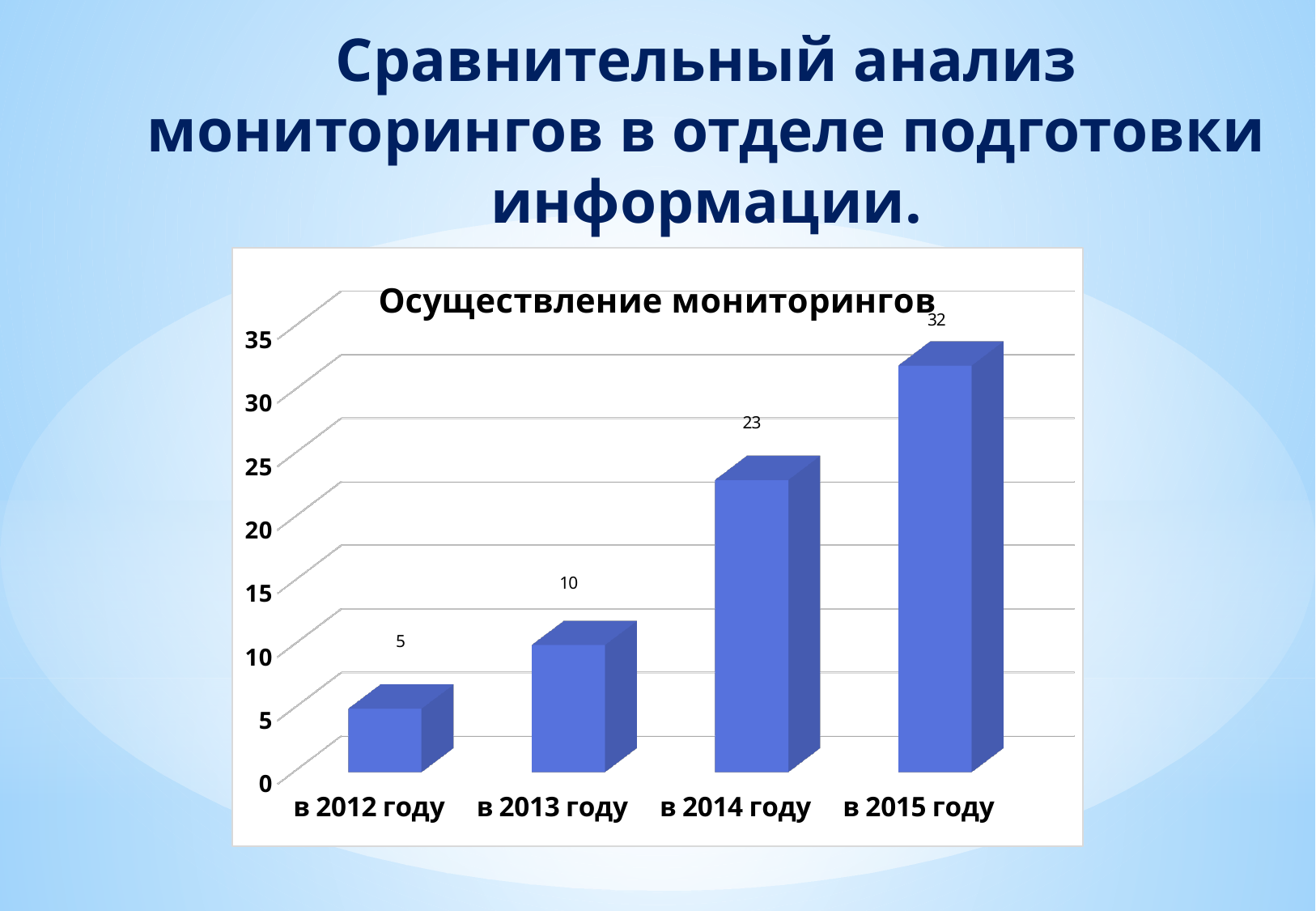
Which is larger, the value for в 2013 году or в 2014 году? в 2014 году What is the difference between the values for в 2013 году and в 2012 году? 5 How many years are shown on the chart? 4 What kind of chart is shown? bar chart Is the value for в 2015 году greater or less than 30? greater Do the values rise or fall from 2012 to 2015? rise Which year has the highest value? в 2015 году What is the value for в 2015 году? 32 What is the value for в 2014 году? 23 Which year has the lowest value? в 2012 году What is the value for в 2012 году? 5 What is the difference between the values for в 2015 году and в 2014 году? 9